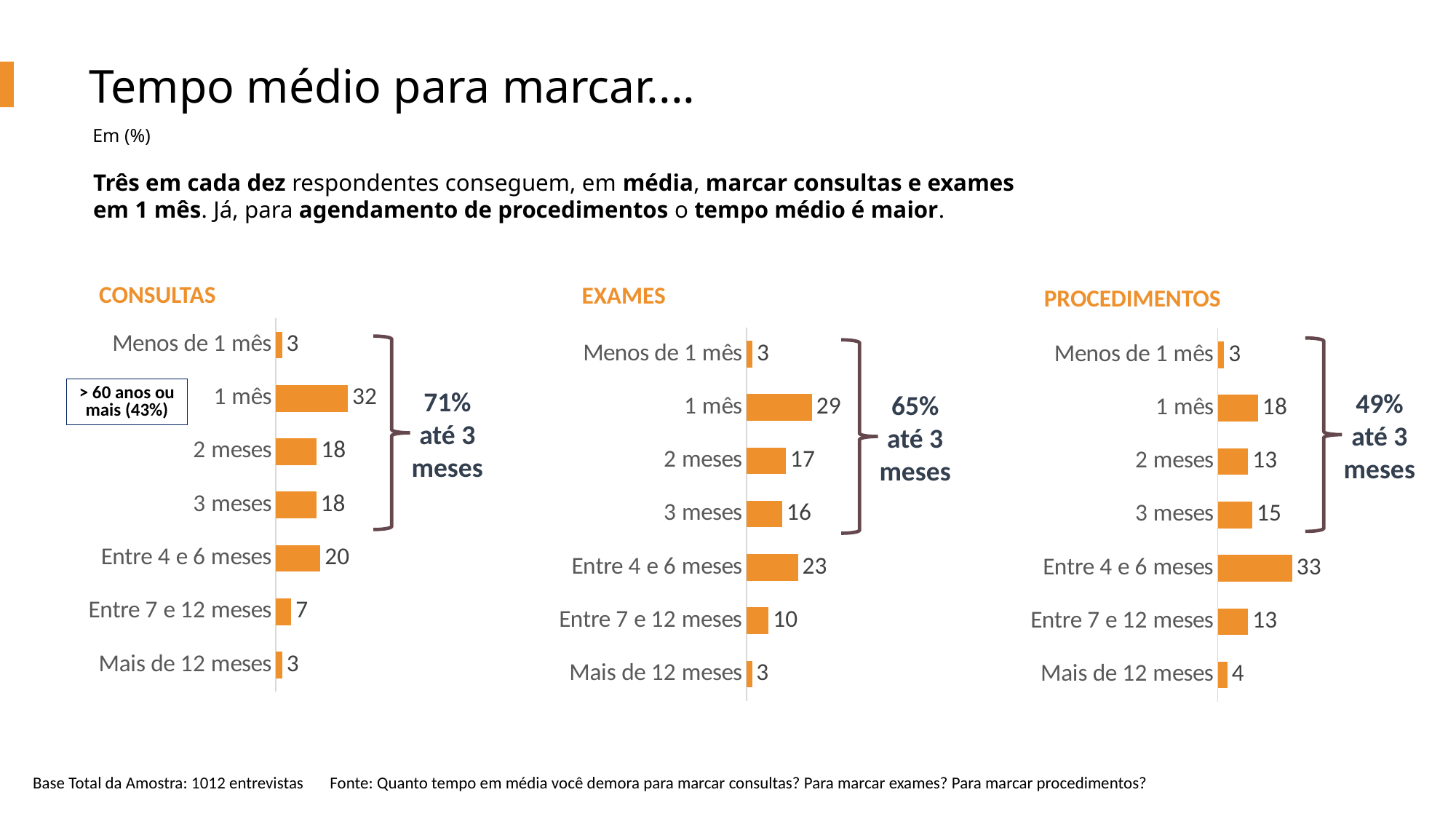
In the EXAMES chart, which category has the lowest value? Menos de 1 mês and Mais de 12 meses (both 3) In the CONSULTAS chart, what is the value for '1 mês'? 32 In the PROCEDIMENTOS chart, which category has the highest value? Entre 4 e 6 meses How many categories does the EXAMES chart show? 7 In the PROCEDIMENTOS chart, what is the value for 'Entre 7 e 12 meses'? 13 Which is larger: '1 mês' in the EXAMES chart or '1 mês' in the PROCEDIMENTOS chart? EXAMES (29) What type of chart is the CONSULTAS chart? Bar chart In the CONSULTAS chart, which category has the highest value? 1 mês In the PROCEDIMENTOS chart, what is the difference between 'Entre 4 e 6 meses' and '1 mês'? 15 In the EXAMES chart, what is the value for 'Entre 4 e 6 meses'? 23 In the CONSULTAS chart, what is the difference between '1 mês' and '2 meses'? 14 What percentage is shown next to the bracket for 'até 3 meses' in the PROCEDIMENTOS chart? 49%